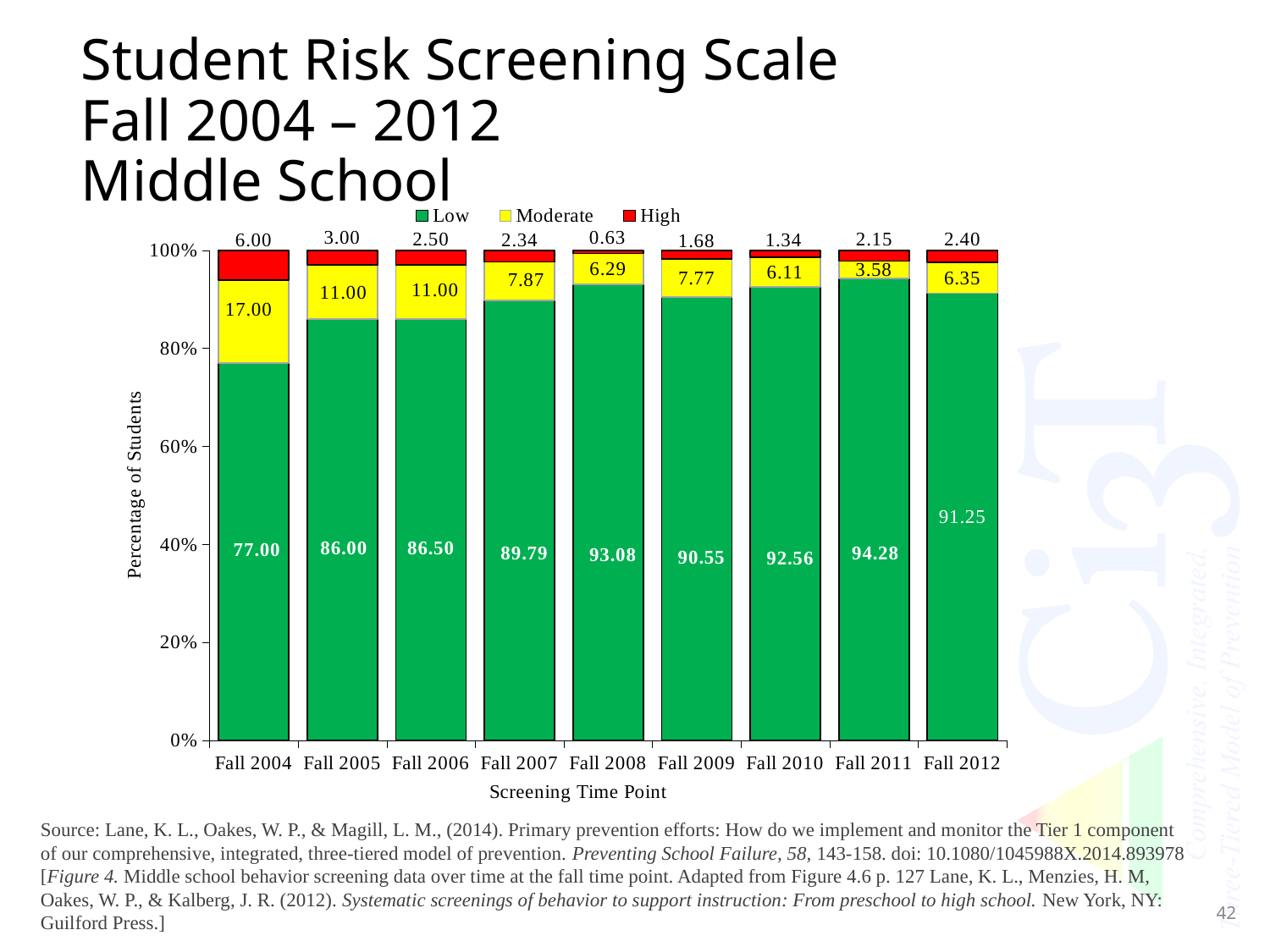
What kind of chart is shown on the slide? Stacked bar chart What is the High value for Fall 2011? 2.15 How many series does the legend list? 3 What is the total of the stacked bar for Fall 2004? 100.00 How many screening time points are shown on the x axis? 9 Which time point has the highest Low value? Fall 2011 What is the Moderate value for Fall 2007? 7.87 What is the difference between the Low value for Fall 2012 and the Low value for Fall 2004? 14.25 Which time point has the lowest High value? Fall 2008 What is the title of the y axis? Percentage of Students Which is larger, the Moderate value for Fall 2005 or the Moderate value for Fall 2011? Fall 2005 What is the Low value for Fall 2004? 77.00